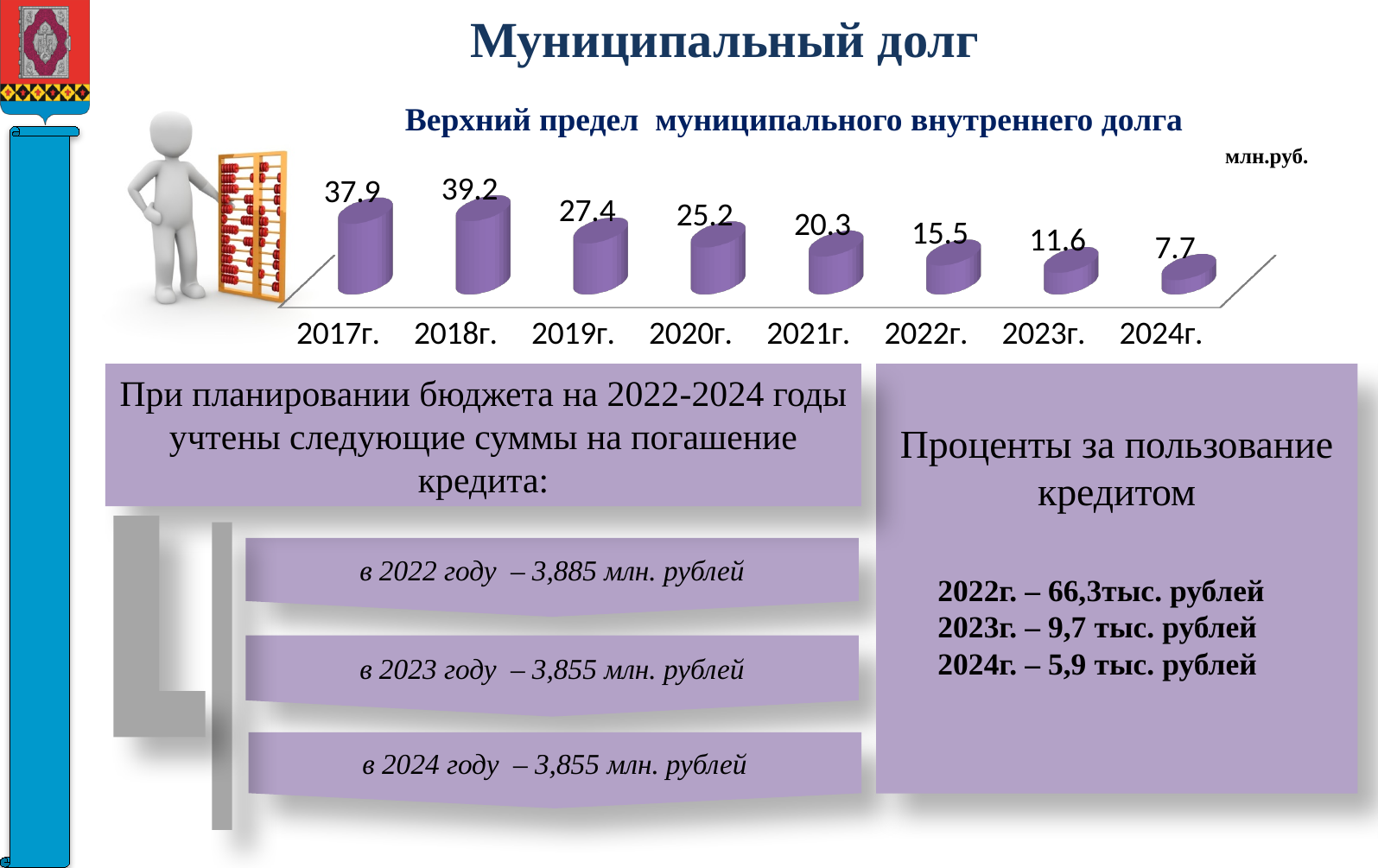
What is the difference between the values for 2017г. and 2024г.? 30.2 What is the value for 2021г. in the chart? 20.3 Do the values rise or fall from 2018г. to 2024г.? fall Which year has the highest value in the chart? 2018г. What is the value for 2018г. in the chart 'Верхний предел муниципального внутреннего долга'? 39.2 What kind of chart is shown on the slide? bar chart What is the value for 2024г. in the chart? 7.7 How many years are shown in the chart? 8 Which is larger, the value for 2022г. or the value for 2023г.? 2022г. Which year has the lowest value in the chart? 2024г. What is the difference between the values for 2019г. and 2020г.? 2.2 What unit is indicated for the values in the chart? млн.руб.